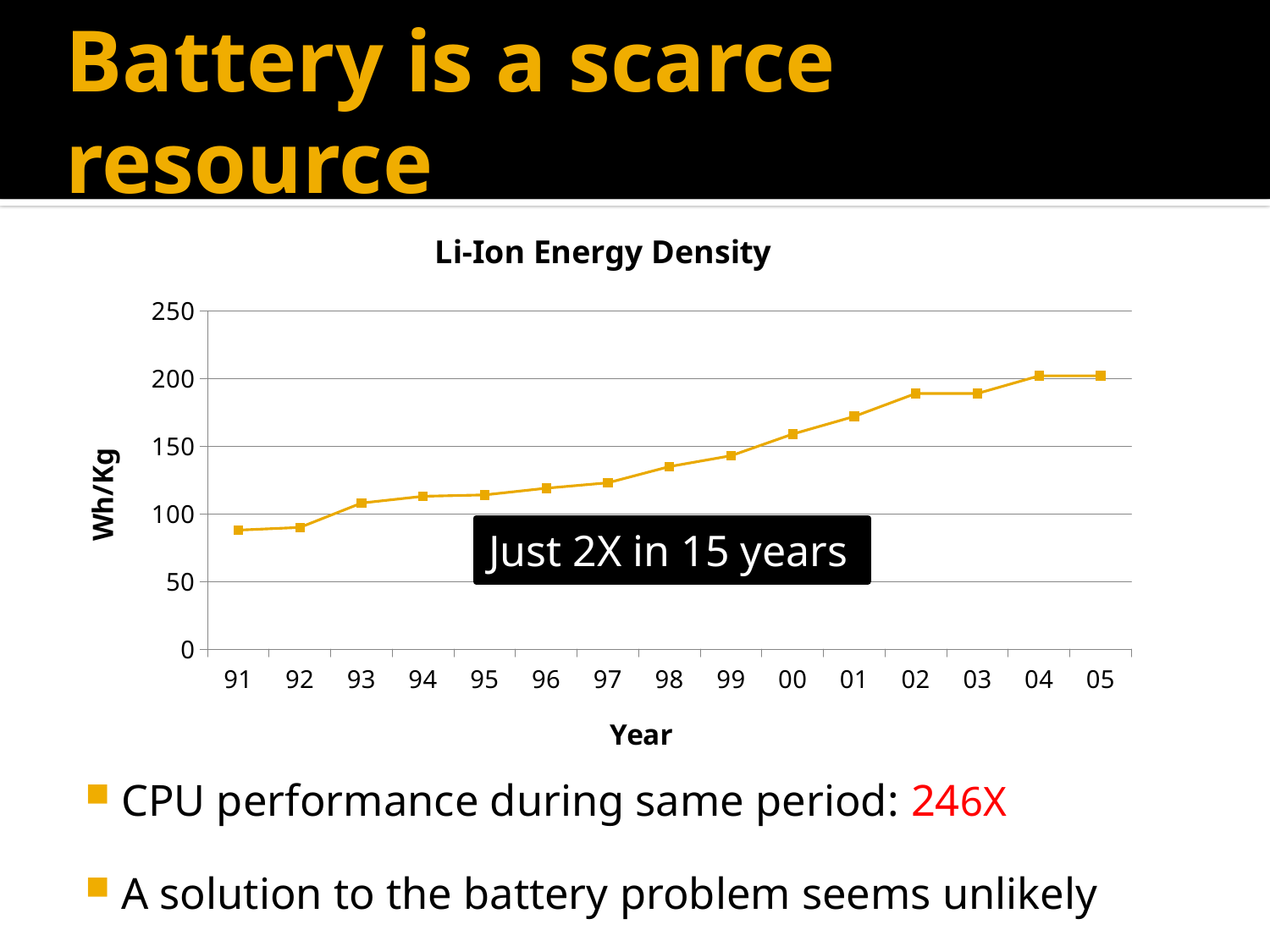
Do the values rise or fall from 91 to 05? rise How many years are plotted on the x axis? 15 Is the value for 01 greater or less than 200? less What is the title of the chart? Li-Ion Energy Density Is the value for 97 greater or less than 100? greater What is the label of the y axis? Wh/Kg What kind of chart is shown on the slide? line chart Which has the larger value, 95 or 00? 00 Is the value for 91 greater or less than 100? less Which has the larger value, 96 or 02? 02